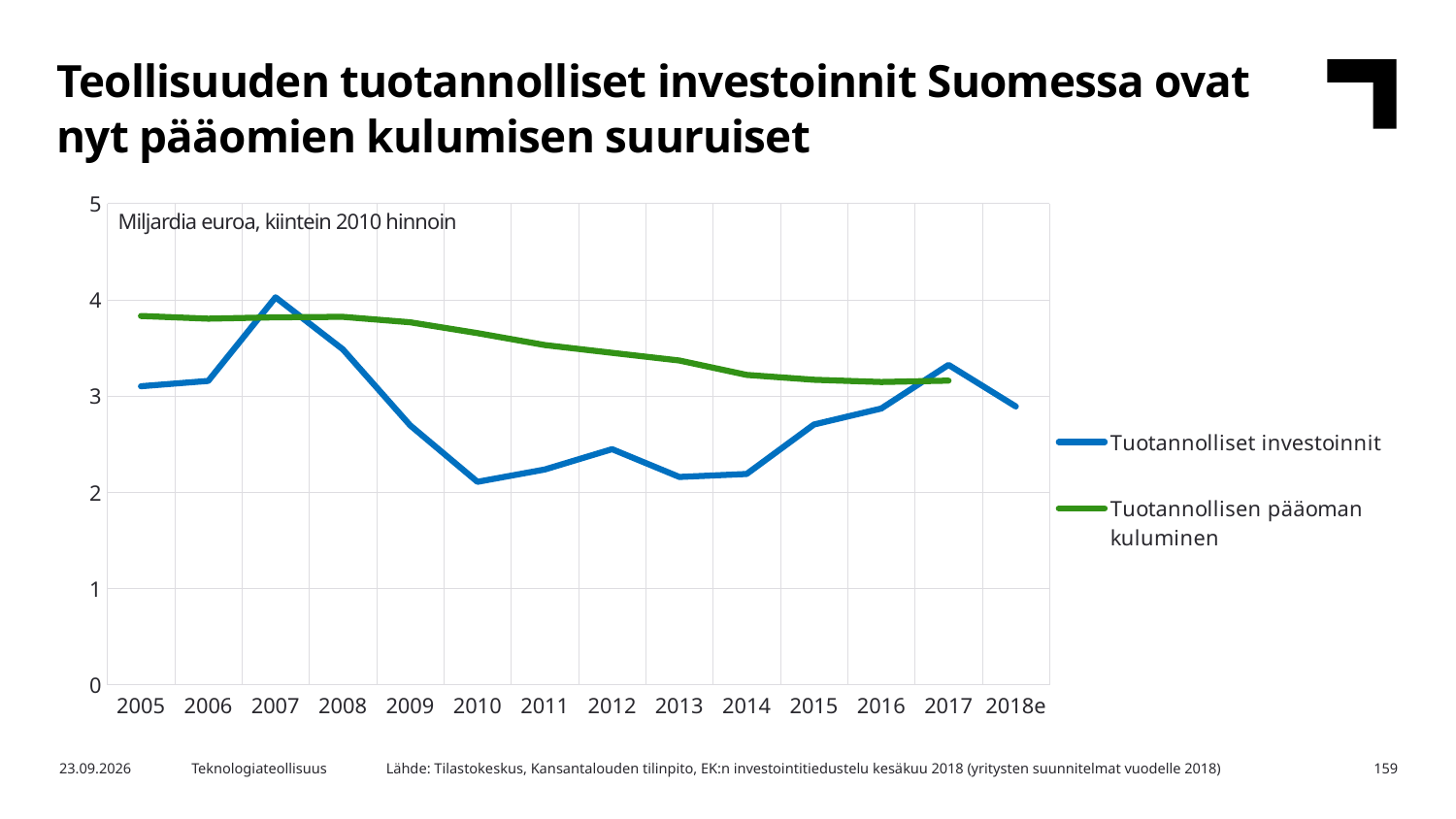
Is the value for Tuotannollisen pääoman kuluminen in 2005 greater or less than 4? less Is the value for Tuotannolliset investoinnit in 2018e greater or less than 3? less In 2010, which series has the larger value, Tuotannolliset investoinnit or Tuotannollisen pääoman kuluminen? Tuotannollisen pääoman kuluminen Does the Tuotannollisen pääoman kuluminen line rise or fall from 2005 to 2017? Fall How many years are shown on the x axis? 14 How many series does the legend list? 2 In which year does the Tuotannolliset investoinnit line reach its highest value? 2007 What kind of chart is shown on the slide? Line chart In 2007, which series has the larger value, Tuotannolliset investoinnit or Tuotannollisen pääoman kuluminen? Tuotannolliset investoinnit What unit is stated in the text inside the chart area? Miljardia euroa, kiintein 2010 hinnoin Is the value for Tuotannolliset investoinnit in 2010 greater or less than 3? less